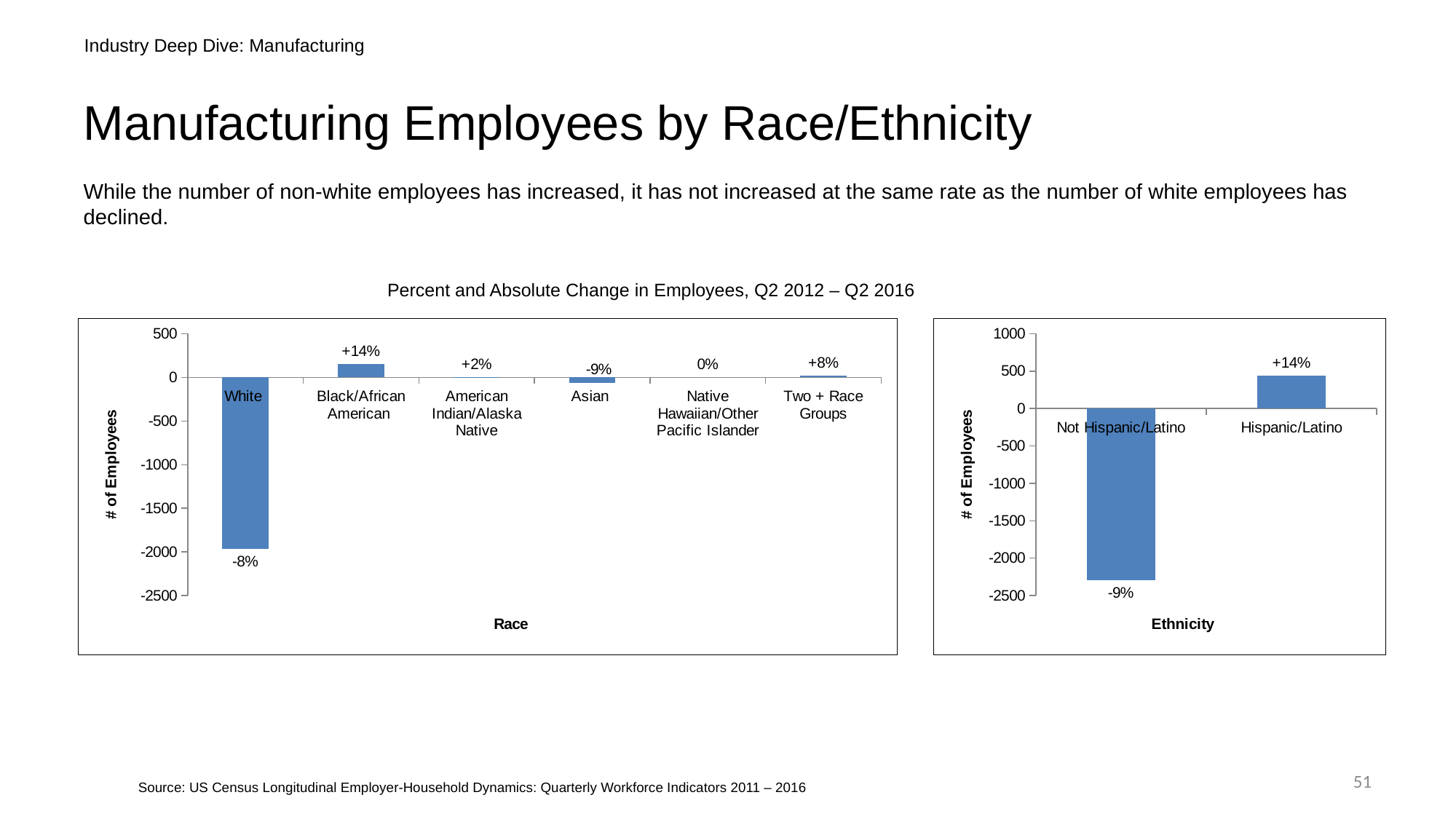
What is the y-axis label on the left chart (Race)? # of Employees On the left chart (Race), is the absolute change for White greater or less than -1500? less On the left chart (Race), which category has the lowest absolute change in employees? White On the left chart (Race), what percent change label is shown for Native Hawaiian/Other Pacific Islander? 0% On the right chart (Ethnicity), what percent change label is shown for Hispanic/Latino? +14% On the left chart (Race), what percent change label is shown for White? -8% On the left chart (Race), what percent change label is shown for Black/African American? +14% What kind of chart is the right chart (Ethnicity)? bar chart On the left chart (Race), what percent change label is shown for Asian? -9% On the right chart (Ethnicity), is the absolute change for Not Hispanic/Latino greater or less than -2000? less On the right chart (Ethnicity), what percent change label is shown for Not Hispanic/Latino? -9% On the left chart (Race), how many race categories are plotted? 6